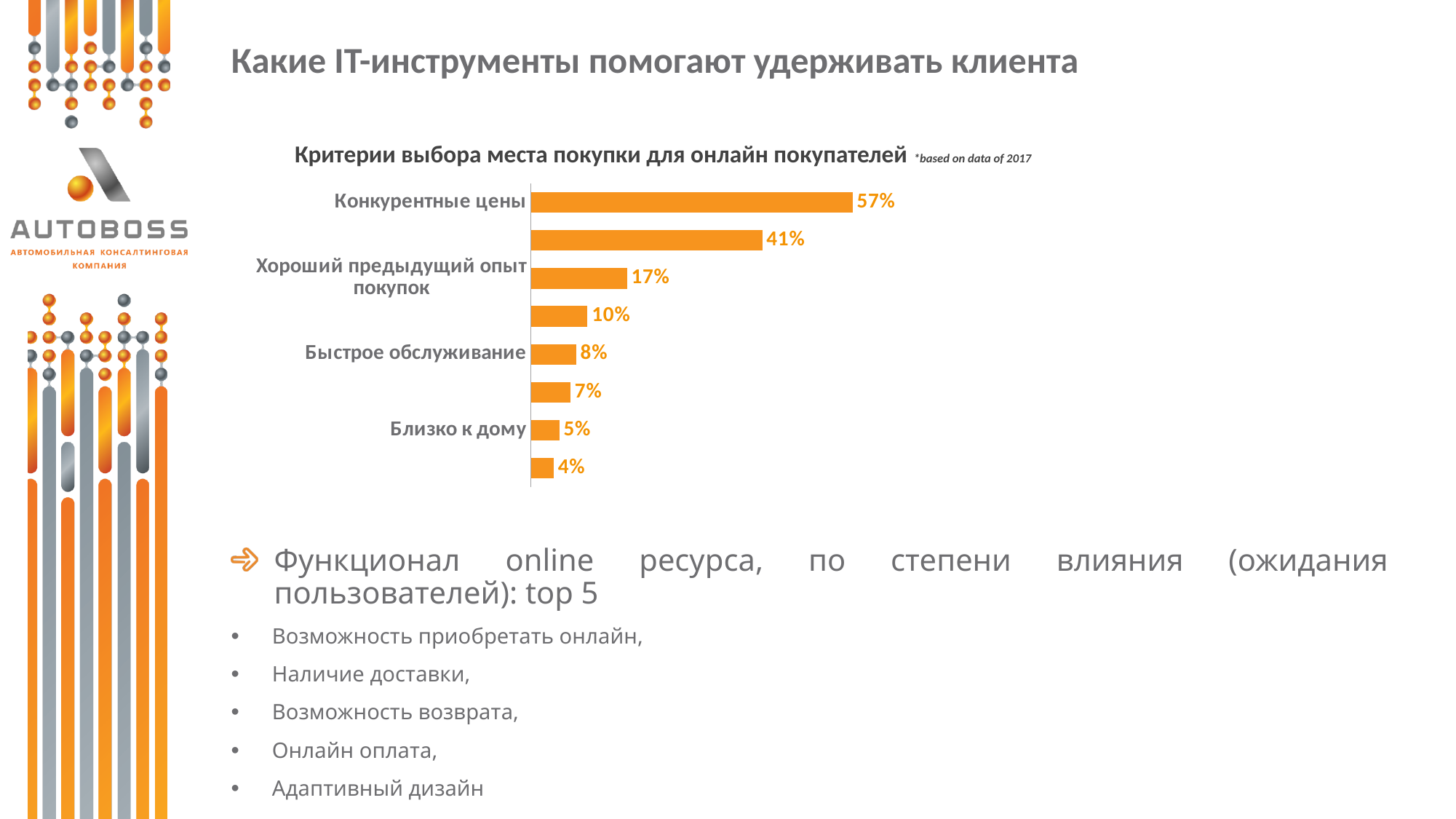
What is the value for Хороший предыдущий опыт покупок? 17% What type of chart is shown on the slide? bar chart Which is larger, the value for Быстрое обслуживание or the value for Близко к дому? Быстрое обслуживание What is the title of the chart? Критерии выбора места покупки для онлайн покупателей What is the difference between the values for Конкурентные цены and Хороший предыдущий опыт покупок? 40% What is the value for Близко к дому? 5% What is the value for Конкурентные цены? 57% What year is the chart's data based on, according to the note next to the title? 2017 Which labelled category has the highest value? Конкурентные цены What is the value of the smallest bar in the chart? 4% How many bars are plotted in the chart? 8 What is the value for Быстрое обслуживание? 8%